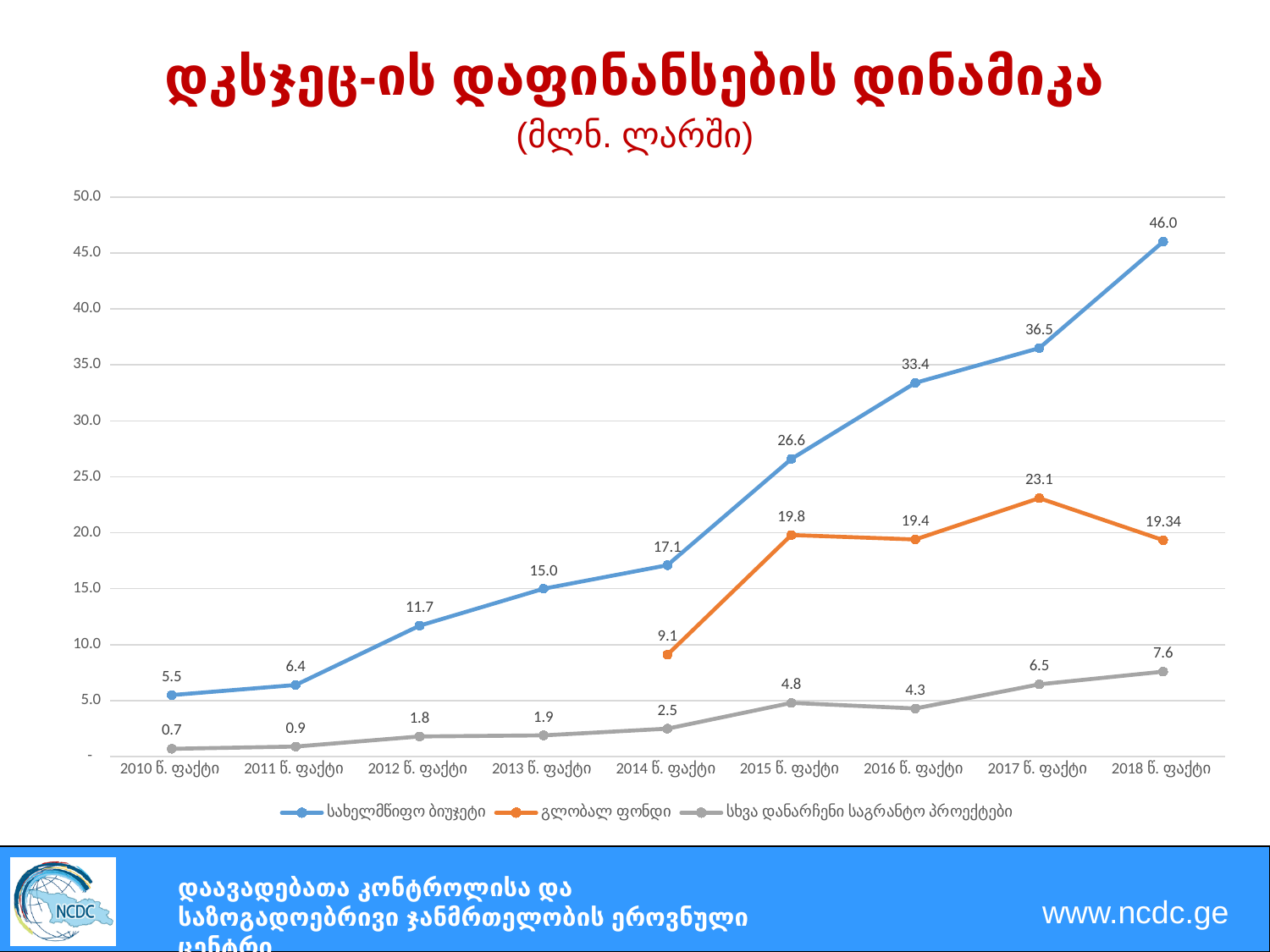
Does the სახელმწიფო ბიუჯეტი series rise or fall from 2010 წ. ფაქტი to 2018 წ. ფაქტი? rise What is the value of the სახელმწიფო ბიუჯეტი (state budget) series for 2018 წ. ფაქტი? 46.0 Which series has the larger value in 2016 წ. ფაქტი: სახელმწიფო ბიუჯეტი or გლობალ ფონდი? სახელმწიფო ბიუჯეტი Is the სახელმწიფო ბიუჯეტი value for 2015 წ. ფაქტი greater or less than 25.0? greater How many series does the legend list? 3 In which year does the სხვა დანარჩენი საგრანტო პროექტები series have its lowest value? 2010 წ. ფაქტი What kind of chart is shown on the slide? line chart What is the value of the გლობალ ფონდი (Global Fund) series for 2017 წ. ფაქტი? 23.1 How many years (categories) are shown on the x axis? 9 What is the difference between the სახელმწიფო ბიუჯეტი values for 2018 წ. ფაქტი and 2017 წ. ფაქტი? 9.5 What is the value of the სხვა დანარჩენი საგრანტო პროექტები (other grant projects) series for 2015 წ. ფაქტი? 4.8 In which year does the სახელმწიფო ბიუჯეტი series reach its highest value? 2018 წ. ფაქტი